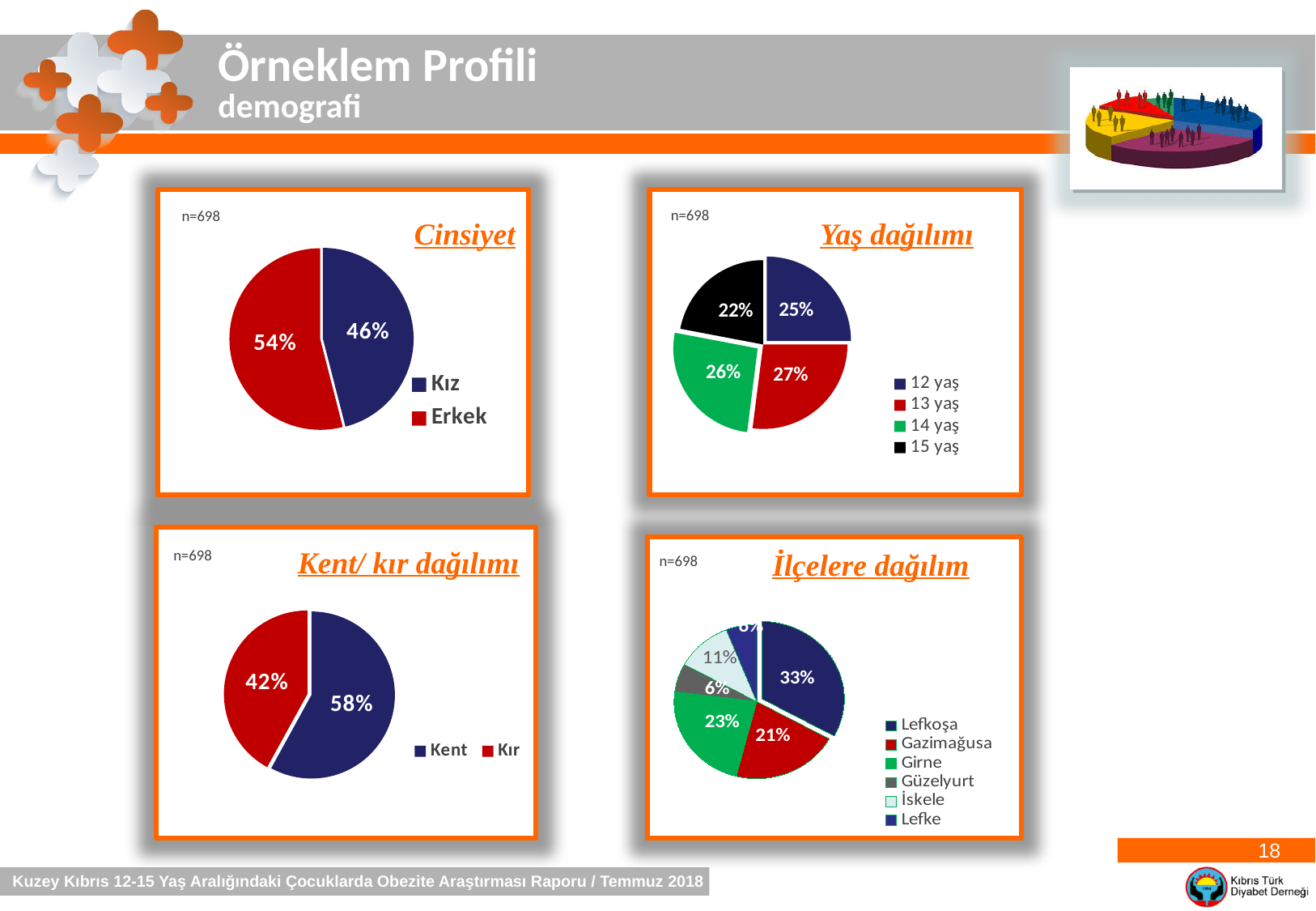
In the Cinsiyet chart, what percentage is Erkek? 54% In the İlçelere dağılım chart, how many districts does the legend list? 6 In the Kent/ kır dağılımı chart, what percentage is Kent? 58% In the Yaş dağılımı chart, what is the difference between the 13 yaş and 15 yaş shares? 5% In the Yaş dağılımı chart, which age group has the smallest share? 15 yaş In the İlçelere dağılım chart, what percentage is Girne? 23% In the Yaş dağılımı chart, how many age groups does the legend list? 4 In the Yaş dağılımı chart, what percentage is 13 yaş? 27% What type of chart is the Cinsiyet chart? Pie chart In the Cinsiyet chart, what percentage is Kız? 46% In the İlçelere dağılım chart, which district has the largest share? Lefkoşa In the Kent/ kır dağılımı chart, which is larger, Kent or Kır? Kent